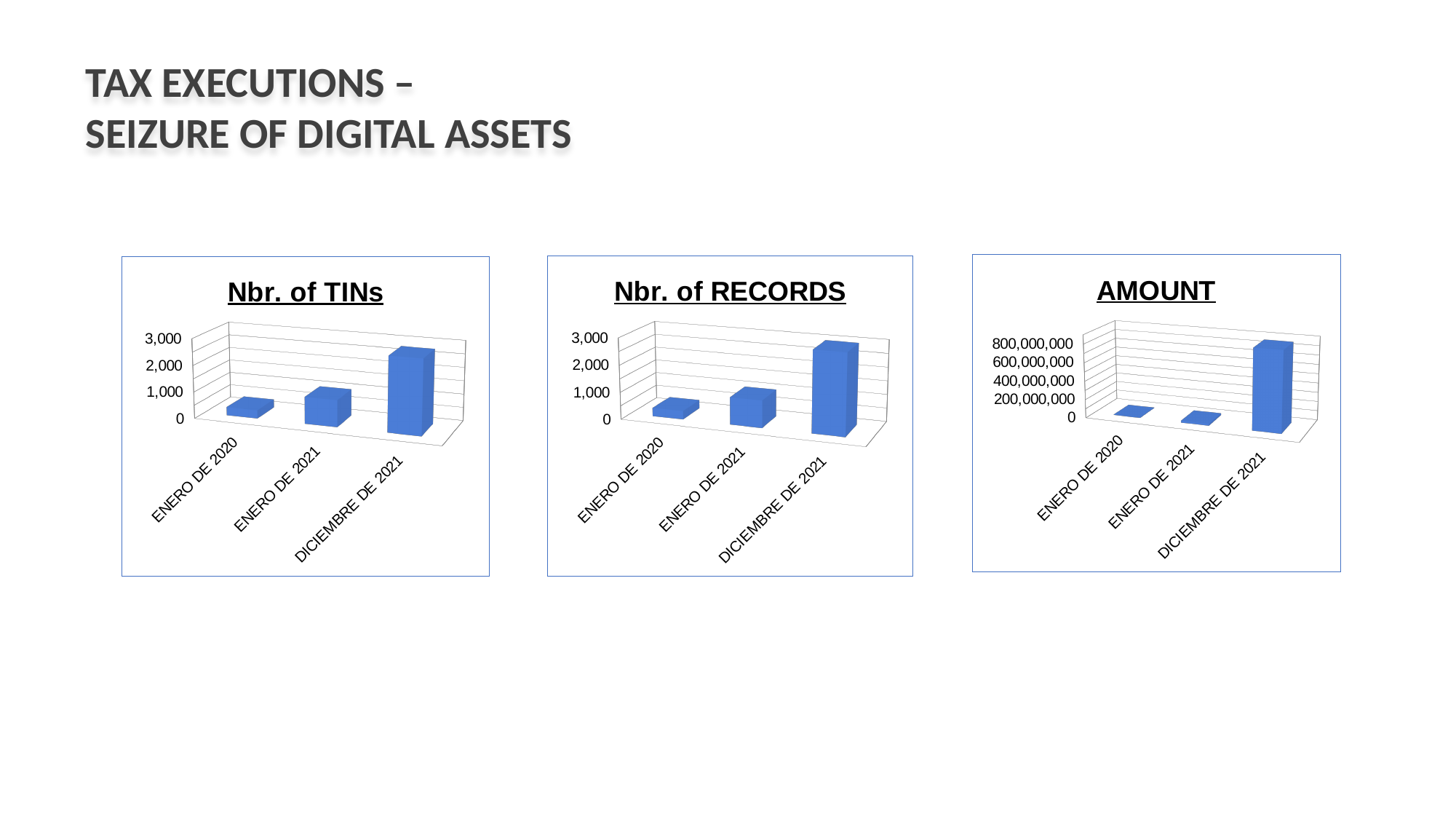
In the "Nbr. of TINs" chart, which category has the highest value? DICIEMBRE DE 2021 In the "AMOUNT" chart, is the value for ENERO DE 2021 greater or less than 200,000,000? less In the "Nbr. of TINs" chart, which category has the lowest value? ENERO DE 2020 In the "Nbr. of TINs" chart, is the value for ENERO DE 2020 greater or less than 1,000? less In the "AMOUNT" chart, is the value for DICIEMBRE DE 2021 greater or less than 400,000,000? greater In the "Nbr. of RECORDS" chart, which is larger: ENERO DE 2020 or ENERO DE 2021? ENERO DE 2021 What is the title of the rightmost chart on the slide? AMOUNT What kind of chart is the "Nbr. of TINs" chart? bar chart In the "Nbr. of RECORDS" chart, which category has the highest value? DICIEMBRE DE 2021 How many categories are shown on the x axis of the "Nbr. of RECORDS" chart? 3 In the "Nbr. of RECORDS" chart, do the values rise or fall from ENERO DE 2020 to DICIEMBRE DE 2021? rise In the "AMOUNT" chart, which category has the highest value? DICIEMBRE DE 2021